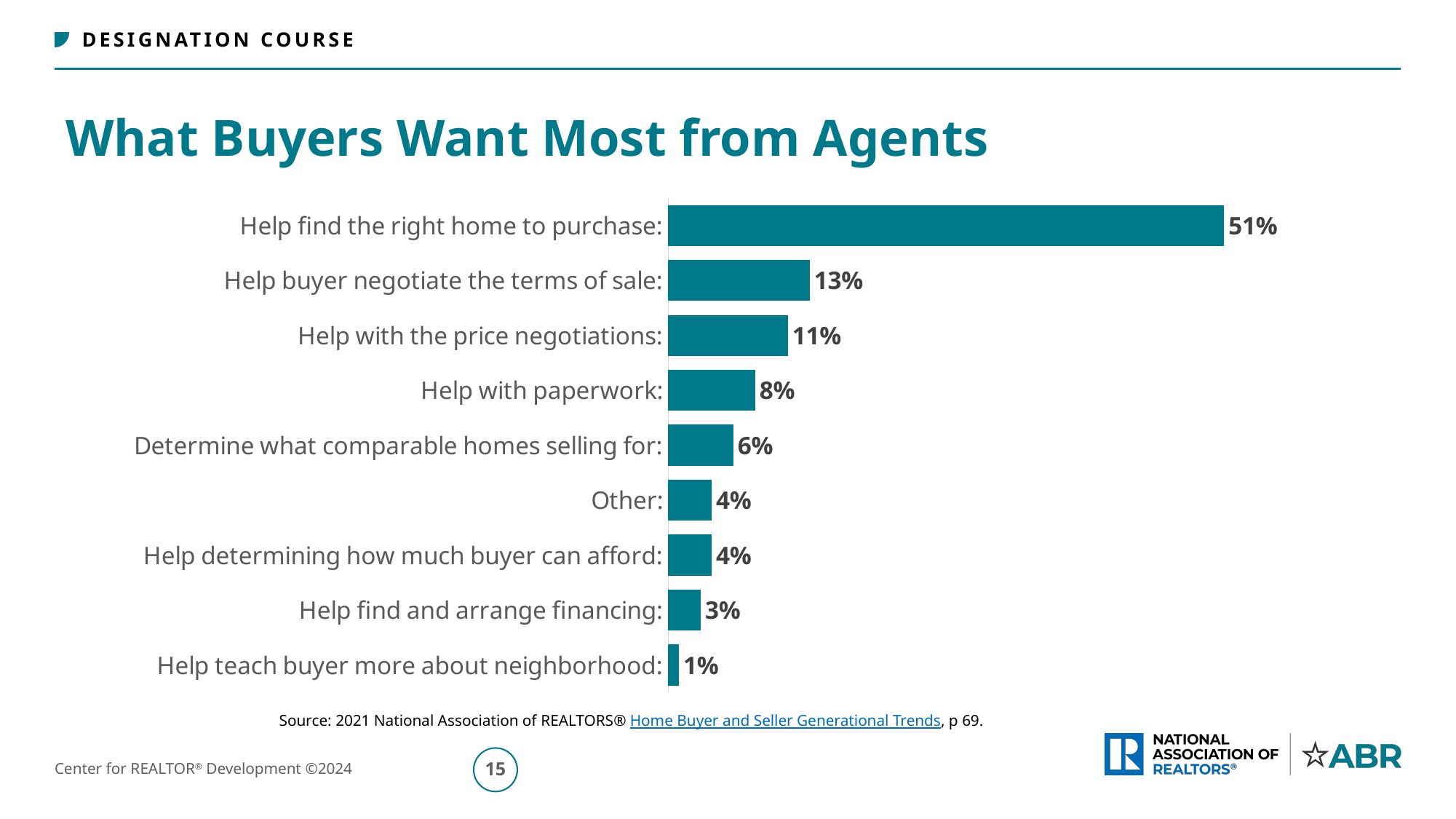
Which is larger: "Help with paperwork" or "Determine what comparable homes selling for"? Help with paperwork What percentage of buyers want help finding the right home to purchase? 51% What is the difference between "Help buyer negotiate the terms of sale" and "Help with the price negotiations"? 2% Which category has the lowest value? Help teach buyer more about neighborhood What is the title of the slide containing the chart? What Buyers Want Most from Agents What is the value for "Other"? 4% What kind of chart is shown on the slide? Bar chart What is the value for "Help find and arrange financing"? 3% What is the difference between "Help find the right home to purchase" and "Help buyer negotiate the terms of sale"? 38% What is the value for "Help with paperwork"? 8% Which category has the highest value? Help find the right home to purchase How many categories are shown in the chart? 9